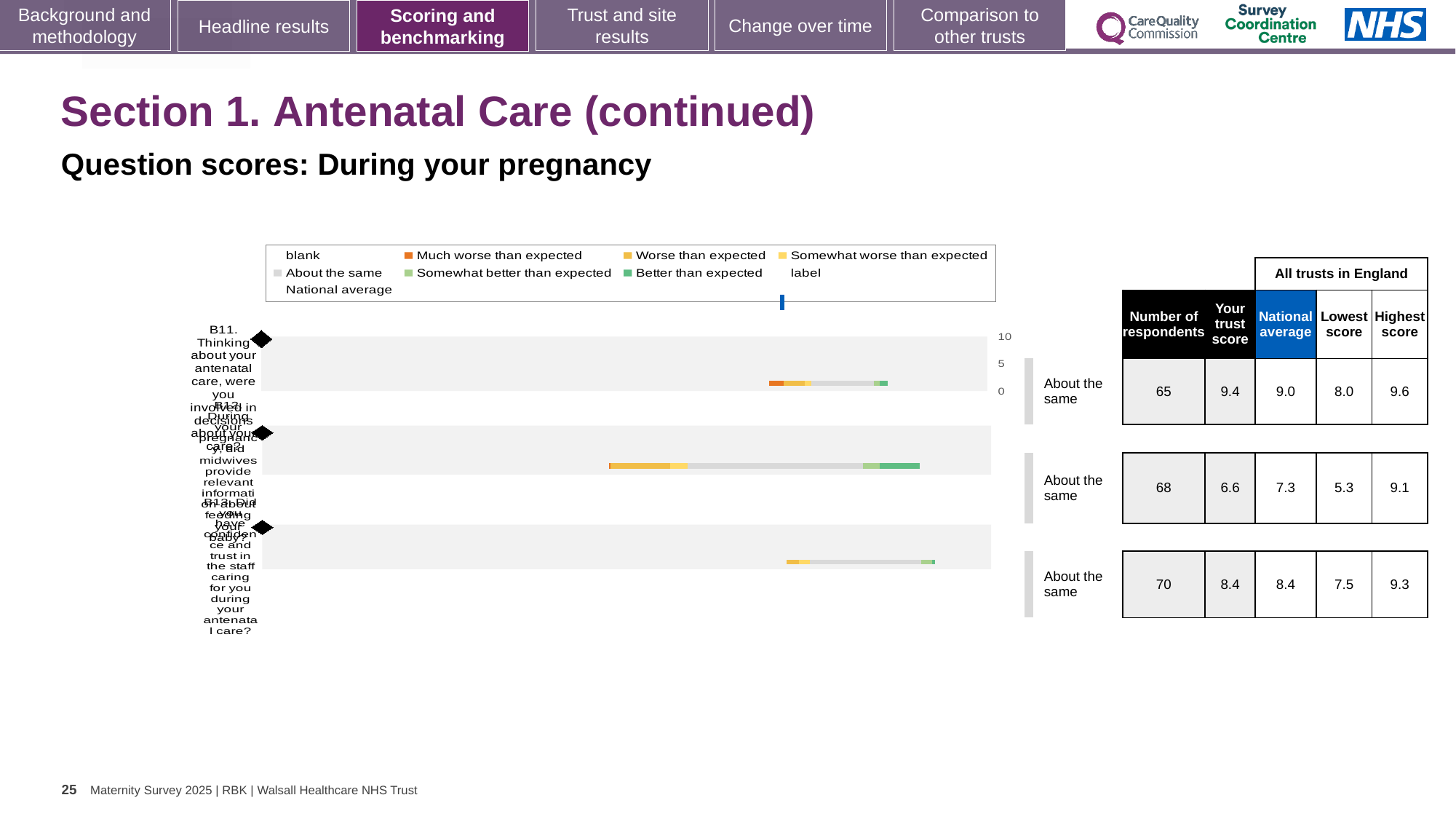
How many questions (categories) are plotted in the chart? 3 What is the national average for question B12? 7.3 What is the 'Your trust score' for question B11? 9.4 What kind of chart is shown on the slide? bar chart Which question has the lowest 'Your trust score'? B12 For question B11, which is larger: the trust score or the national average? the trust score What is the highest score across all trusts in England for question B13? 9.3 What is the difference between the national average and the trust score for question B12? 0.7 What is the number of respondents for question B12? 68 Which question has the highest 'Your trust score'? B11 Which colour in the legend represents 'Much worse than expected'? orange What benchmark category is shown for question B13? About the same